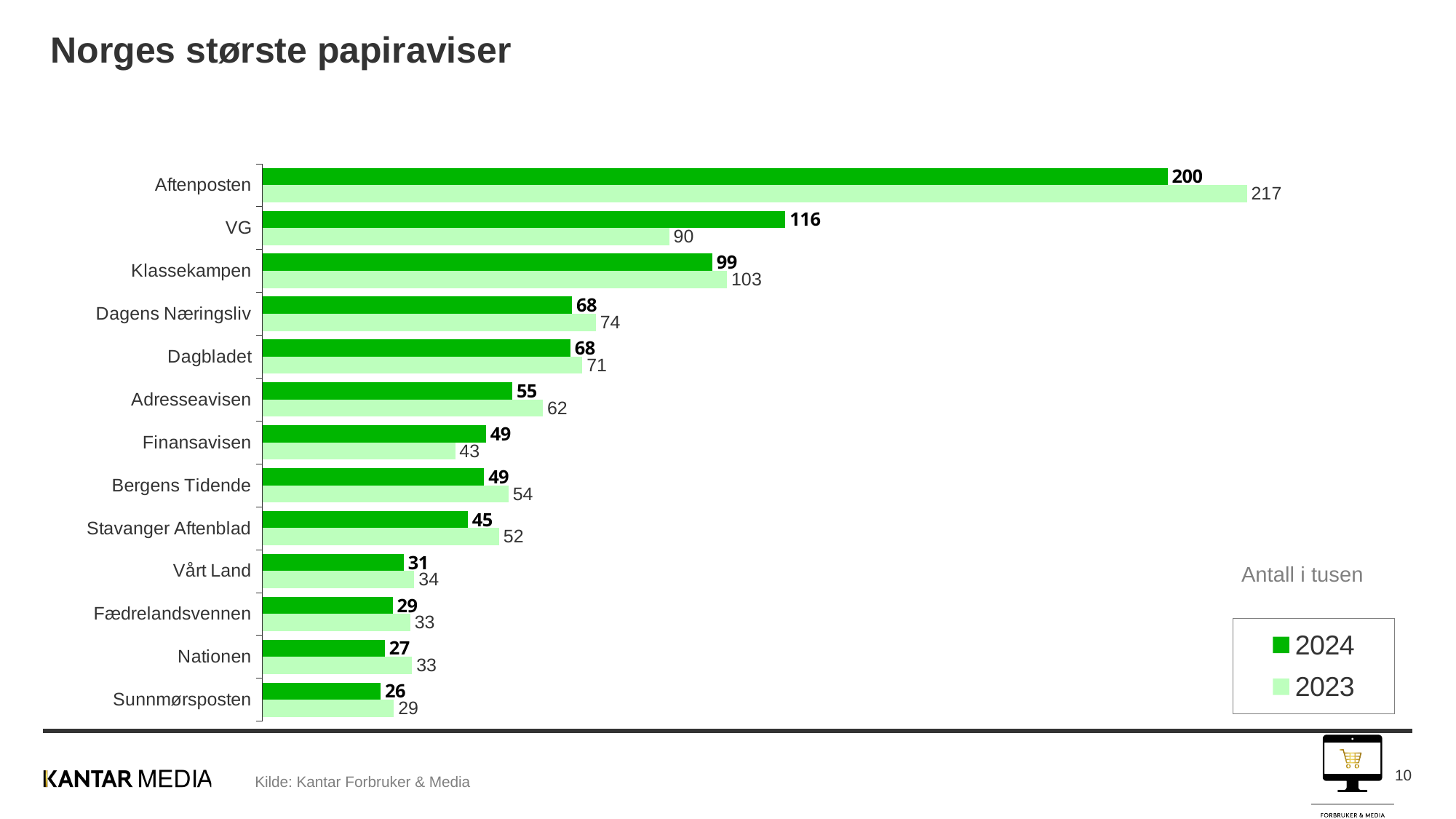
Which is larger for Klassekampen, the 2024 value or the 2023 value? 2023 What is the 2023 value for VG? 90 How many newspapers are shown in the chart? 13 How many series does the legend list? 2 Which is larger for Finansavisen, the 2024 value or the 2023 value? 2024 Which newspaper has the lowest 2024 value? Sunnmørsposten Which newspaper has the highest 2024 value? Aftenposten What is the difference between the 2023 and 2024 values for Aftenposten? 17 What is the difference between the 2024 and 2023 values for VG? 26 What is the 2024 value for Stavanger Aftenblad? 45 What type of chart is shown on the slide? Bar chart What is the 2024 value for Aftenposten? 200